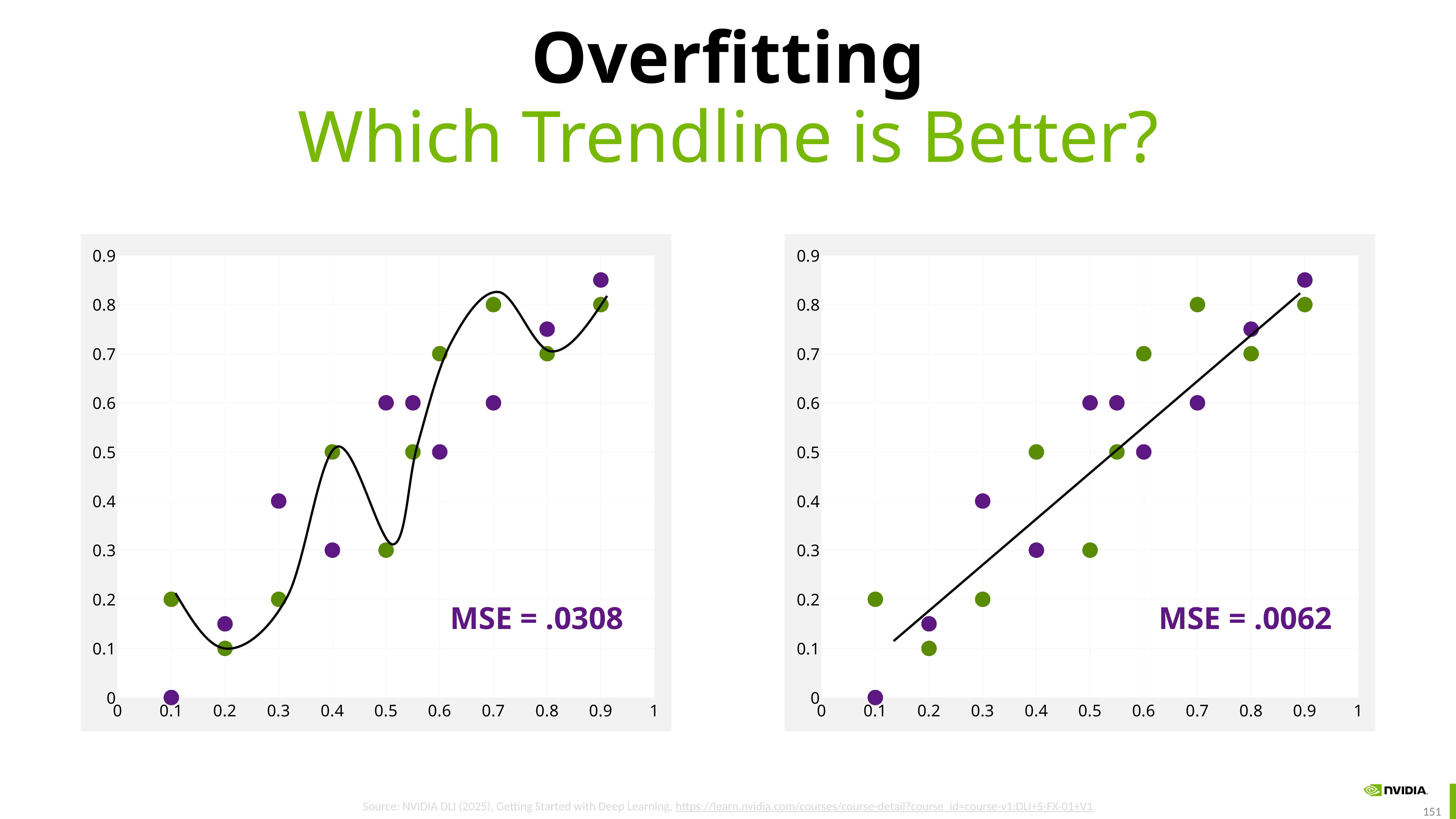
Which chart has the lower MSE, the left chart or the right chart? the right chart On the right chart, is the y value of the purple point at x = 0.9 greater or less than 0.8? greater On the right chart, what is the MSE value shown? MSE = .0062 On the right chart, what is the y value of the green point at x = 0.7? 0.8 What is the difference between the MSE of the left chart and the MSE of the right chart? .0246 On the left chart, which point has the highest y value, the purple point at x = 0.9 or the green point at x = 0.9? the purple point at x = 0.9 What kind of chart is shown on the left of the slide? scatter chart What is the maximum value shown on the y axis of the left chart? 0.9 On the right chart, do the points generally rise or fall as x increases? rise On the left chart, what is the y value of the green point at x = 0.1? 0.2 On the left chart, what is the MSE value shown? MSE = .0308 On the left chart, what is the y value of the purple point at x = 0.1? 0